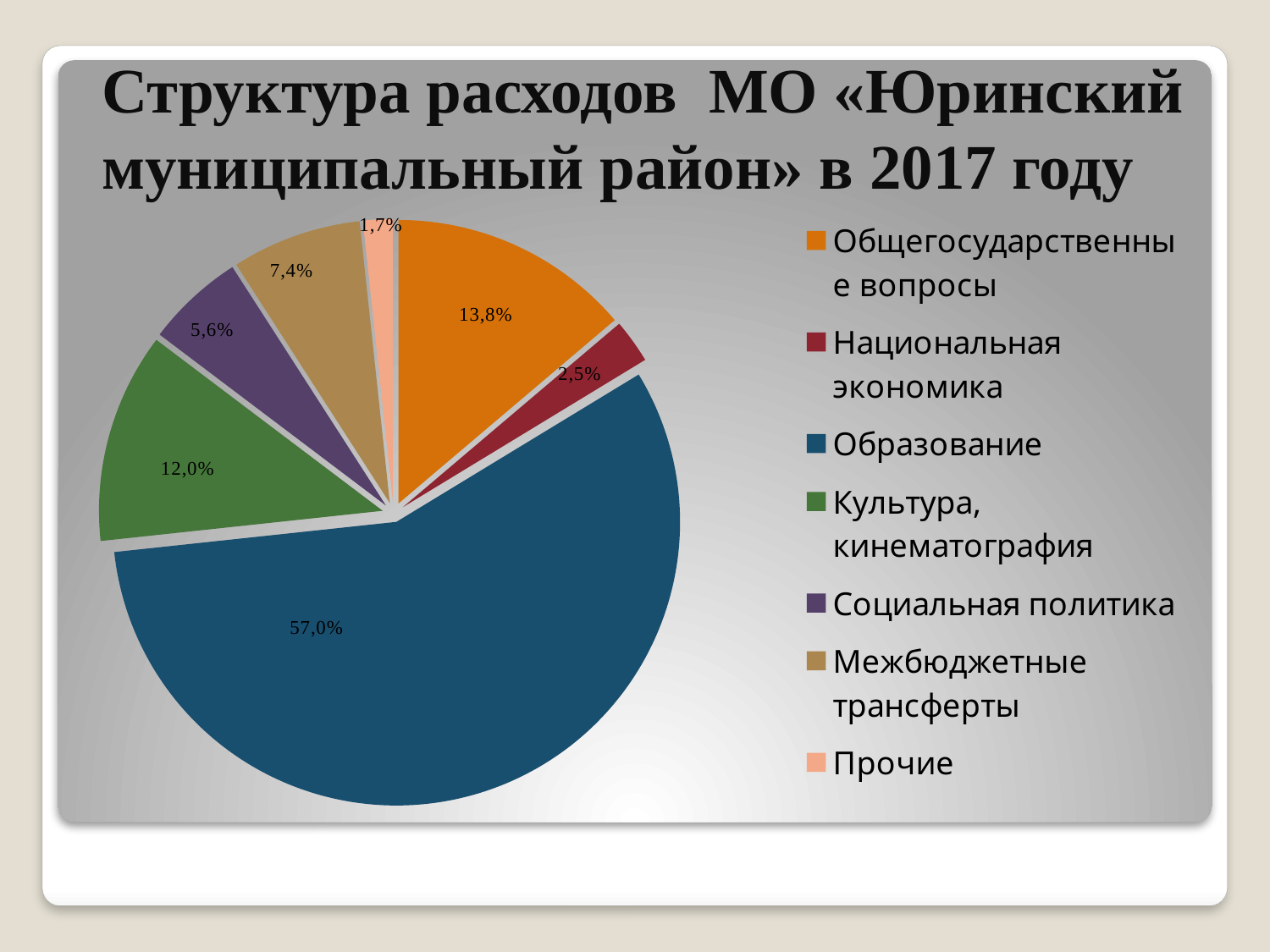
What is the value shown for Межбюджетные трансферты? 7,4% How many categories does the legend list? 7 Which is larger, the share for Культура, кинематография or the share for Межбюджетные трансферты? Культура, кинематография What is the value shown for Общегосударственные вопросы? 13,8% Which category has the largest slice of the pie? Образование What is the value shown for Социальная политика? 5,6% What is the value shown for Культура, кинематография? 12,0% What kind of chart is shown on the slide? Pie chart What is the difference between the shares of Образование and Общегосударственные вопросы? 43,2% What share of the pie does Образование have? 57,0% What is the value shown for Национальная экономика? 2,5% Which category has the smallest slice of the pie? Прочие